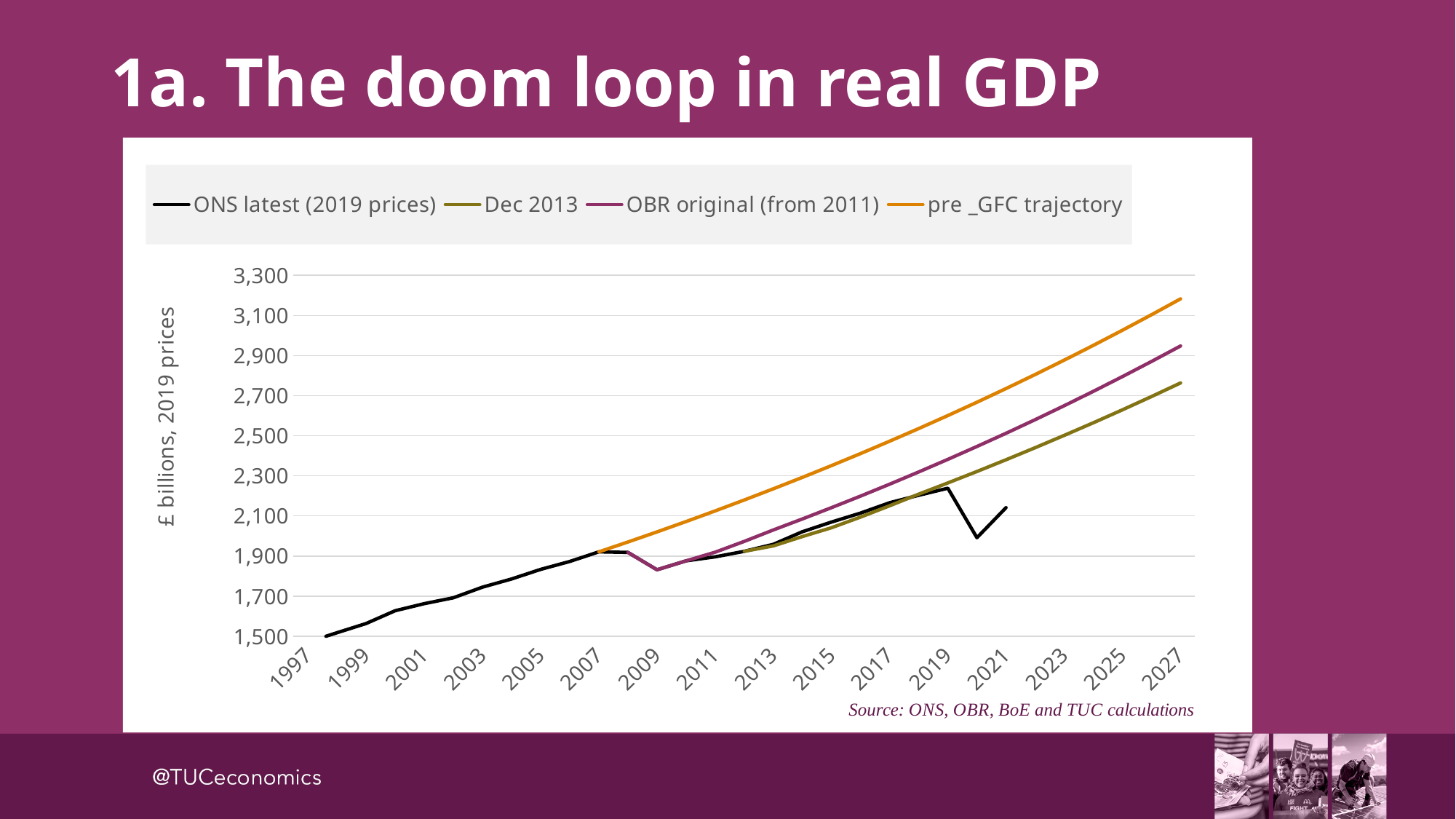
Is the value of the pre _GFC trajectory in 2027 greater or less than 3,100? greater What kind of chart is shown on the slide? line chart Is the value of Dec 2013 in 2027 greater or less than 2,500? greater How many series does the legend list? 4 Which series has the lowest value in 2027? Dec 2013 What is the label on the vertical axis? £ billions, 2019 prices Which series is shown in orange in the legend? pre _GFC trajectory Does the pre _GFC trajectory line rise or fall from 2007 to 2027? rise In 2027, which is higher: OBR original (from 2011) or Dec 2013? OBR original (from 2011) Which series has the highest value in 2027? pre _GFC trajectory Is the value of ONS latest (2019 prices) in 2020 greater or less than 2,100? less How many year labels are shown on the horizontal axis? 16